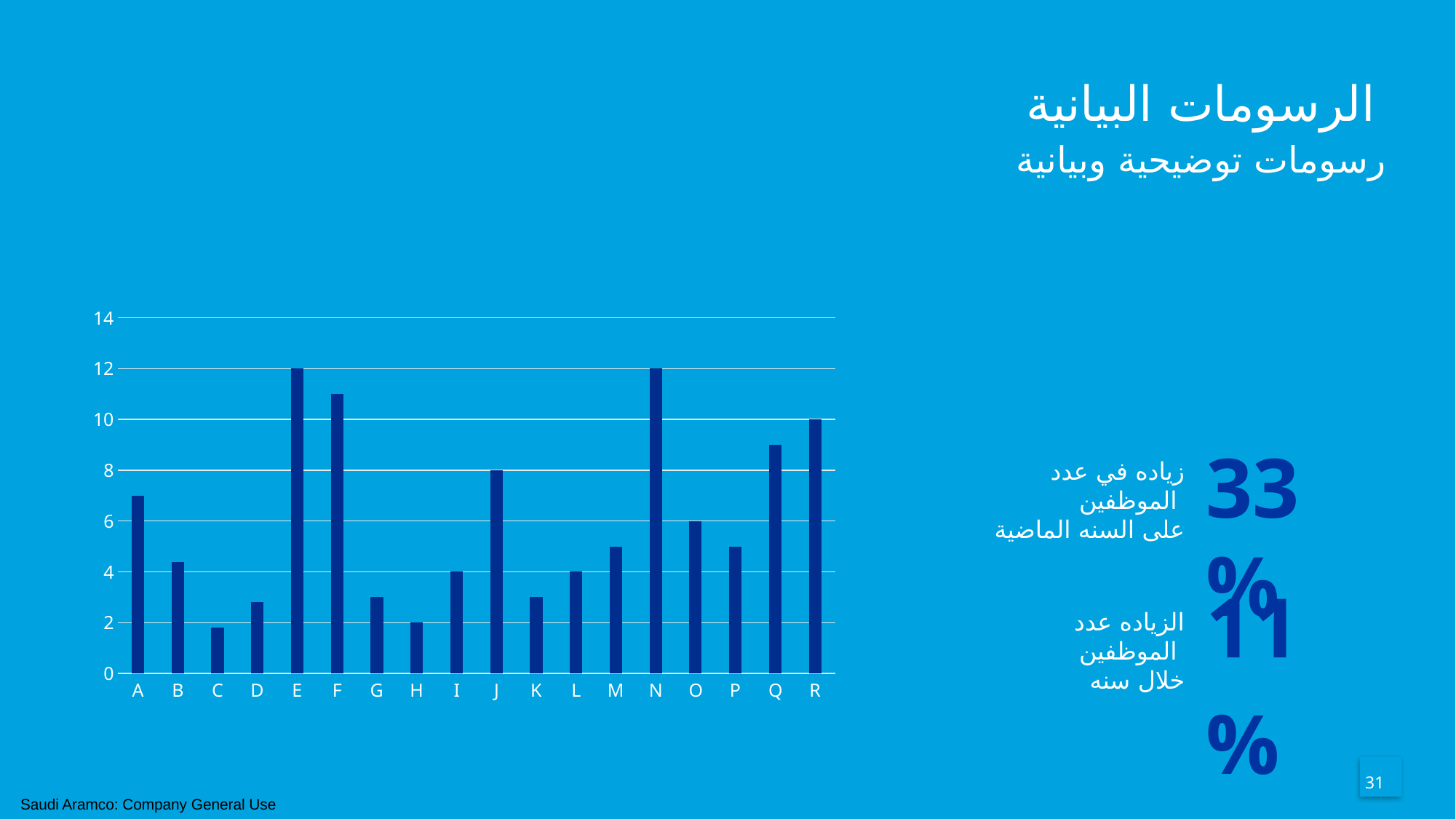
What is the difference between the values for categories E and H? 10 What is the value for category E in the bar chart? 12 Is the value for category Q greater or less than 8? greater Is the value for category F greater or less than 10? greater What kind of chart is shown on the slide? bar chart How many categories are plotted on the x axis of the bar chart? 18 What is the value for category J in the bar chart? 8 What is the highest value shown on the y axis of the bar chart? 14 Which is larger, the value for category E or the value for category A? E What is the value for category R in the bar chart? 10 What is the value for category H in the bar chart? 2